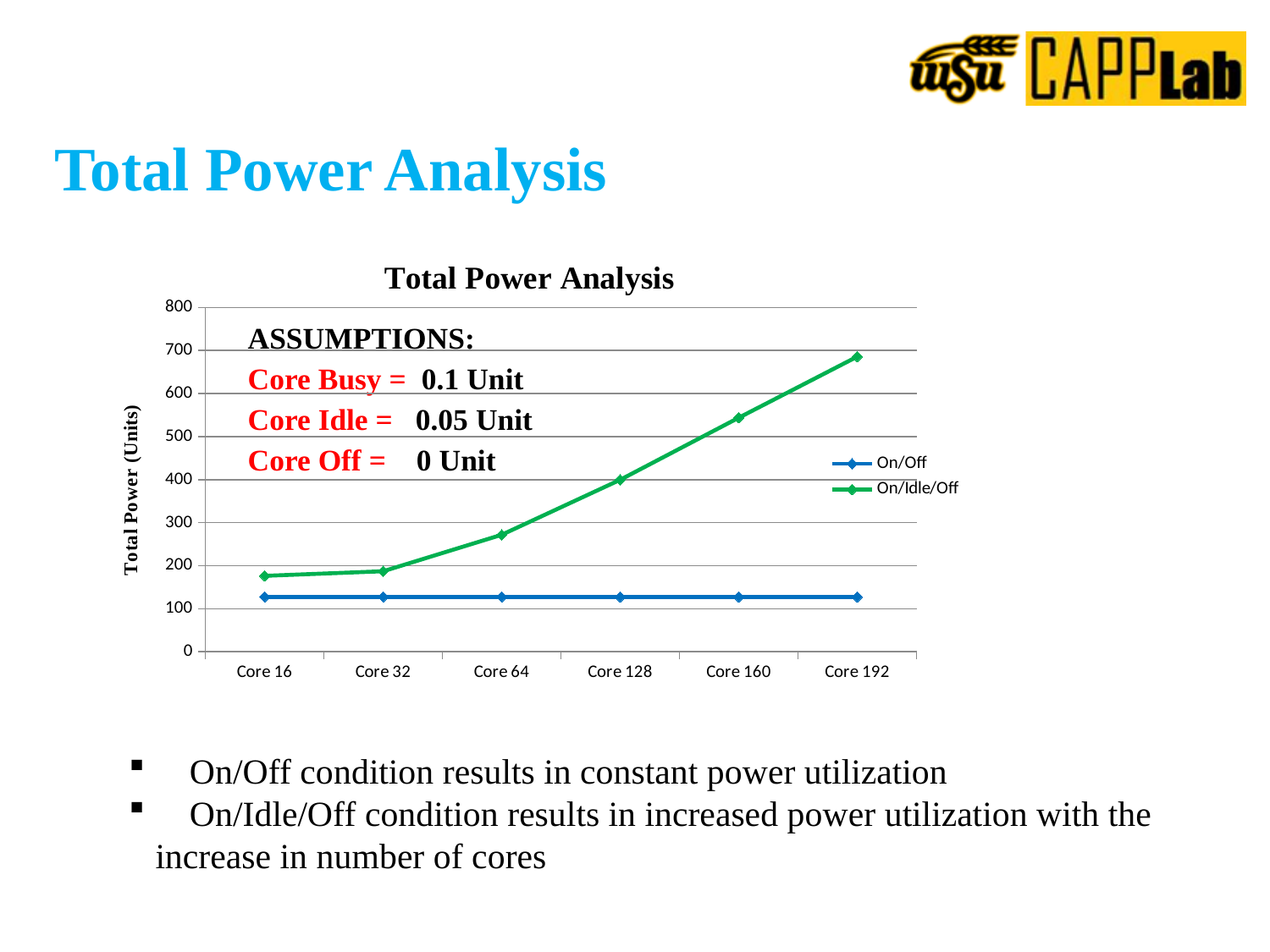
What kind of chart is shown on the slide? line chart Is the On/Idle/Off value for Core 128 greater or less than 300? greater At Core 160, which series has the larger value, On/Off or On/Idle/Off? On/Idle/Off How many core categories are shown on the x axis? 6 Is the On/Off value for Core 64 greater or less than 200? less Is the On/Idle/Off value for Core 16 greater or less than 200? less Does the On/Idle/Off series rise or fall as the number of cores increases along the x axis? rise At which core category does the On/Idle/Off series reach its highest value? Core 192 What is the label of the vertical axis? Total Power (Units) How many series does the legend list? 2 What is the title of the chart? Total Power Analysis